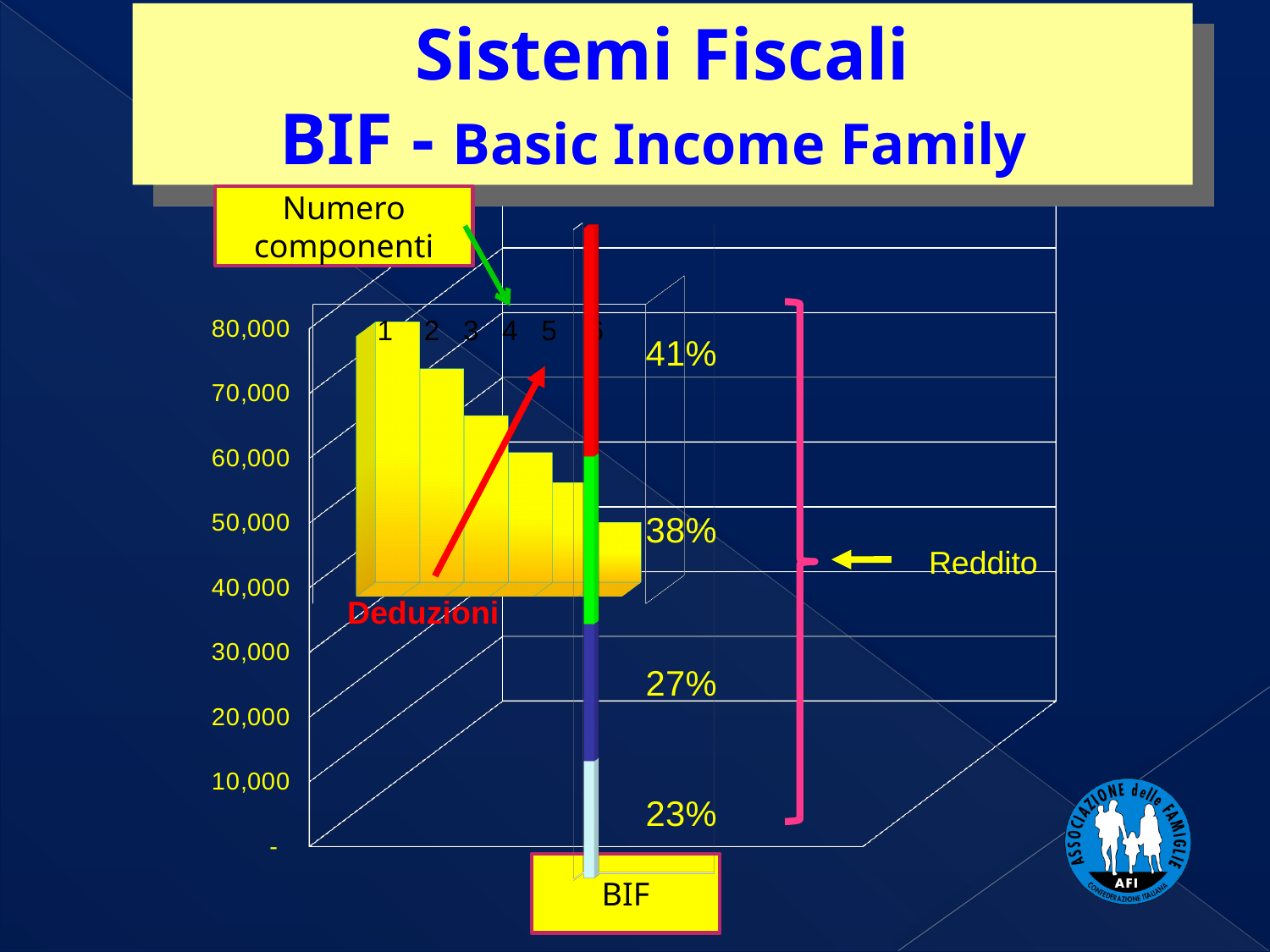
Is the bar for 'Numero componenti' 1 taller or shorter than the bar for 6? taller What kind of chart is shown on the slide? bar chart Which 'Numero componenti' category has the shortest bar? 6 What percentage label appears at the top of the vertical stacked bar next to the chart? 41% What is the highest value shown on the vertical axis? 80,000 Do the bars rise or fall as the number of components increases from 1 to 6? fall How many 'Numero componenti' categories are plotted as bars? 6 Which 'Numero componenti' category has the tallest bar? 1